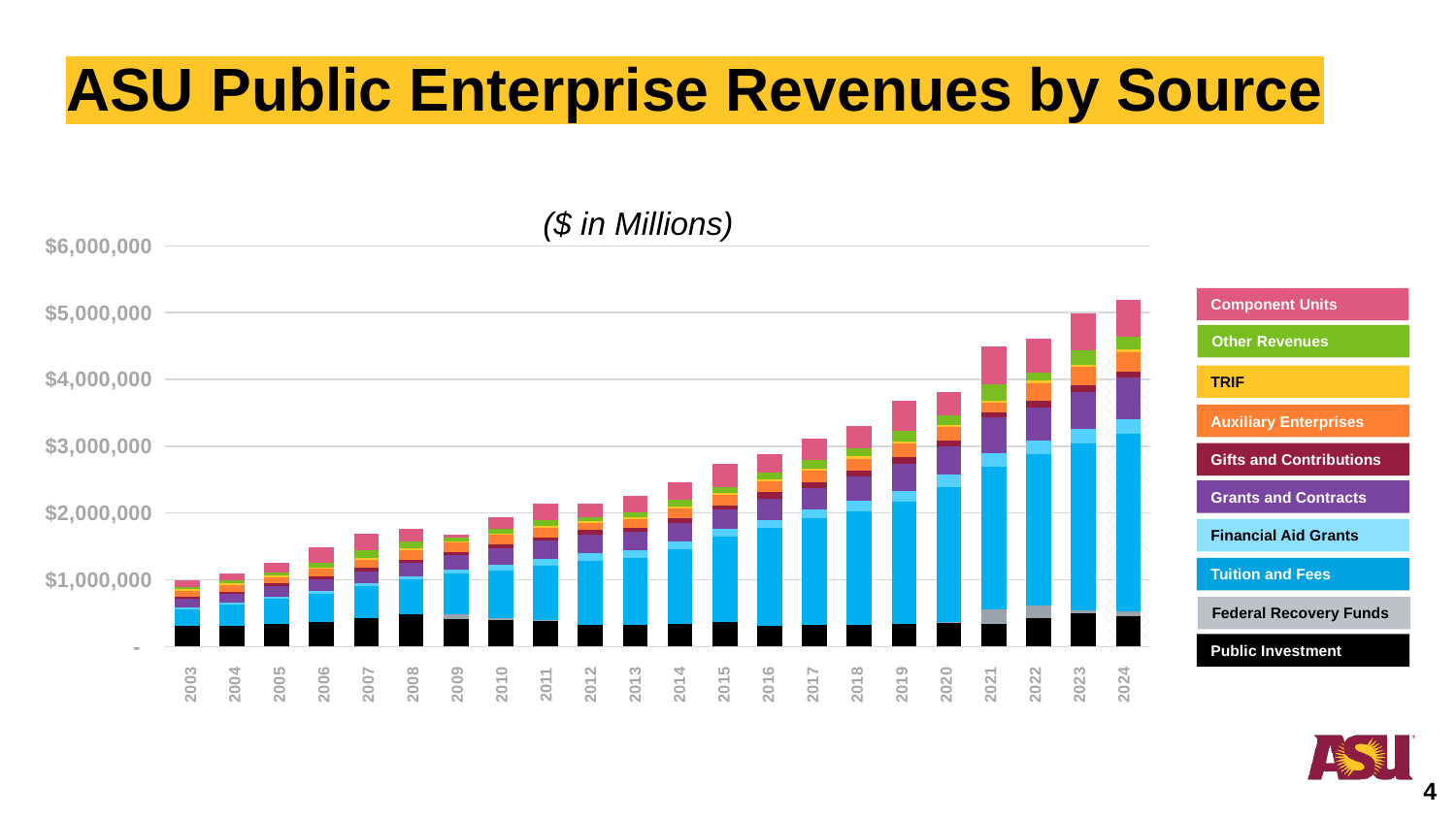
What is the title of the chart on the slide? ASU Public Enterprise Revenues by Source Is the total revenue for 2015 greater or less than $3,000,000? less Which year has the lowest total revenue? 2003 Which year has the larger total revenue, 2020 or 2021? 2021 Is the total revenue for 2021 greater or less than $4,000,000? greater Which year has the highest total revenue? 2024 Is the total revenue for 2024 greater or less than $5,000,000? greater Which revenue source is listed at the bottom of the legend? Public Investment Do total revenues generally rise or fall from 2003 to 2024? Rise What kind of chart is shown on the slide? Stacked bar chart How many years are shown along the x axis of the chart? 22 How many revenue sources does the legend list? 10